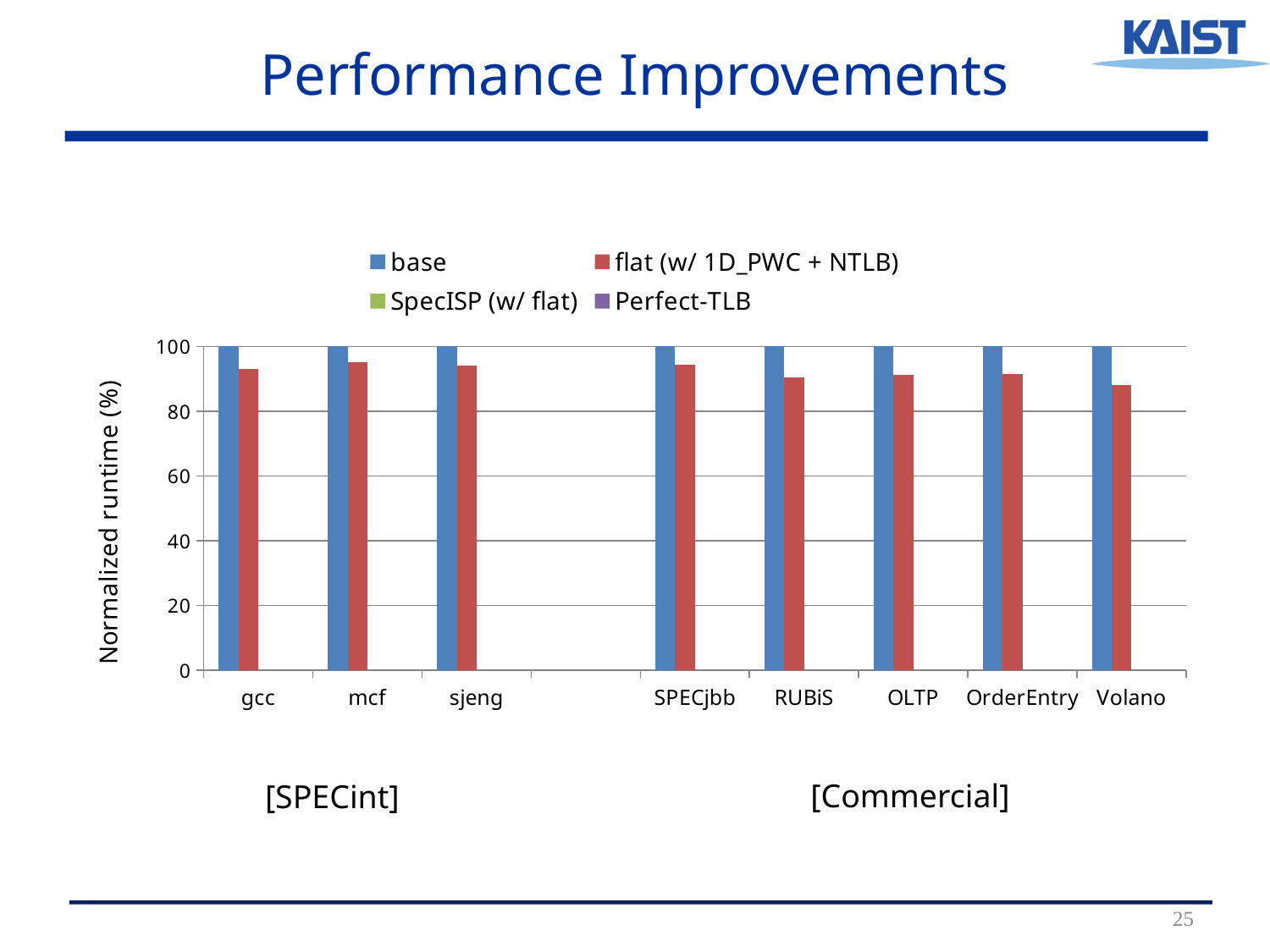
What is the title of the slide containing the chart? Performance Improvements How many series does the legend list? 4 Is the value of the flat (w/ 1D_PWC + NTLB) series for RUBiS greater or less than 100? less Which has the larger flat (w/ 1D_PWC + NTLB) value, mcf or Volano? mcf Which category has the lowest value for the flat (w/ 1D_PWC + NTLB) series? Volano What is the value of the base series for Volano? 100 What is the value of the base series for gcc? 100 What is the label of the y axis? Normalized runtime (%) Is the value of the flat (w/ 1D_PWC + NTLB) series for Volano greater or less than 80? greater What kind of chart is shown on the slide? bar chart For mcf, which series has the larger value, base or flat (w/ 1D_PWC + NTLB)? base How many labeled categories are on the x axis? 8